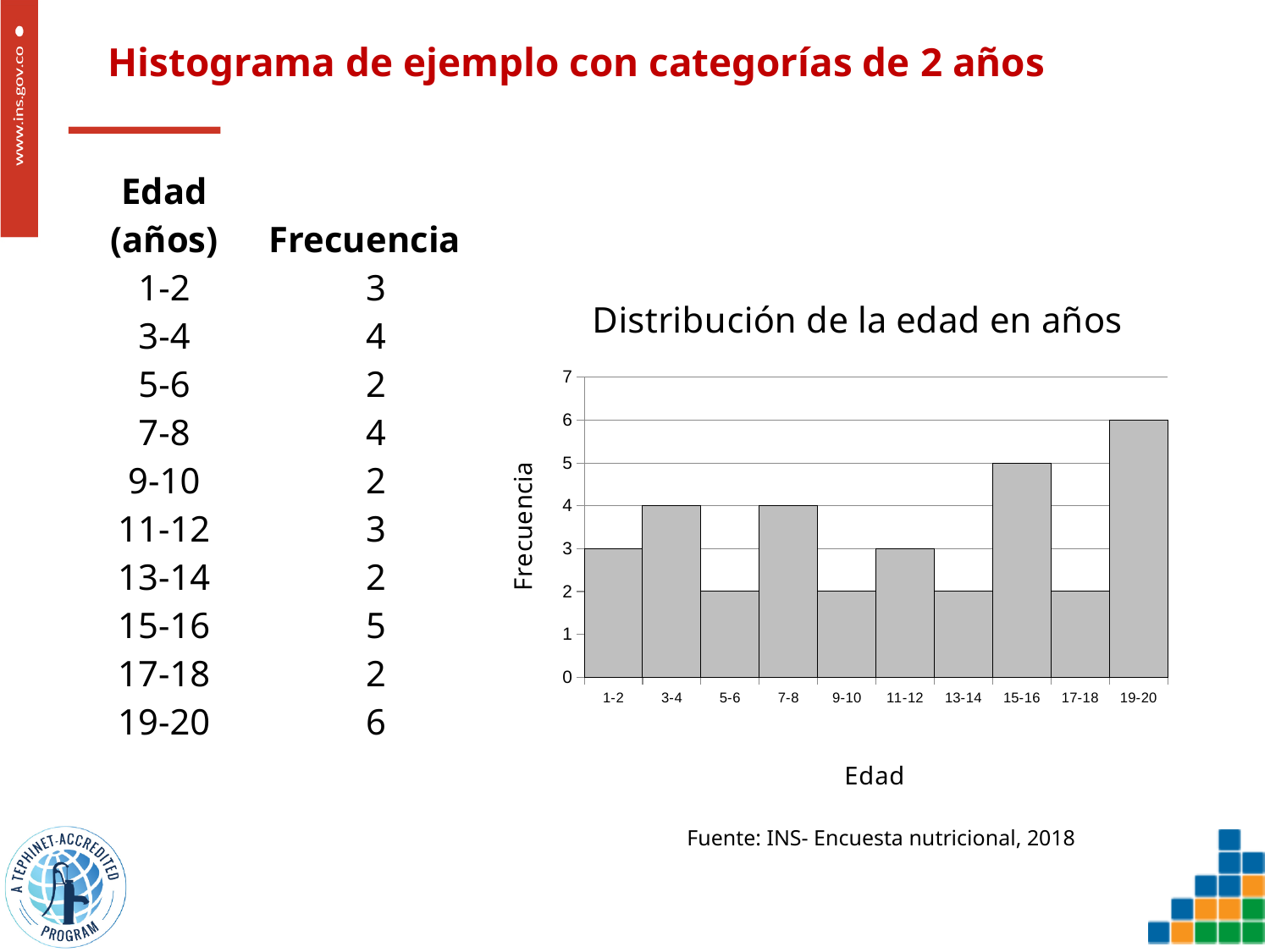
What is the frequency for the 15-16 age group? 5 Which age group has the highest frequency? 19-20 Which has a higher frequency, the 3-4 age group or the 11-12 age group? 3-4 What kind of chart is shown on the slide? Bar chart (histogram) What is the title of the chart? Distribución de la edad en años What is the frequency for the 5-6 age group? 2 What is the difference in frequency between the 7-8 and 9-10 age groups? 2 What is the frequency for the 19-20 age group in the chart? 6 What is the label of the y axis of the chart? Frecuencia How many age groups are shown on the x axis of the chart? 10 Is the frequency for the 15-16 age group greater or less than 4? greater What is the difference in frequency between the 19-20 and 15-16 age groups? 1